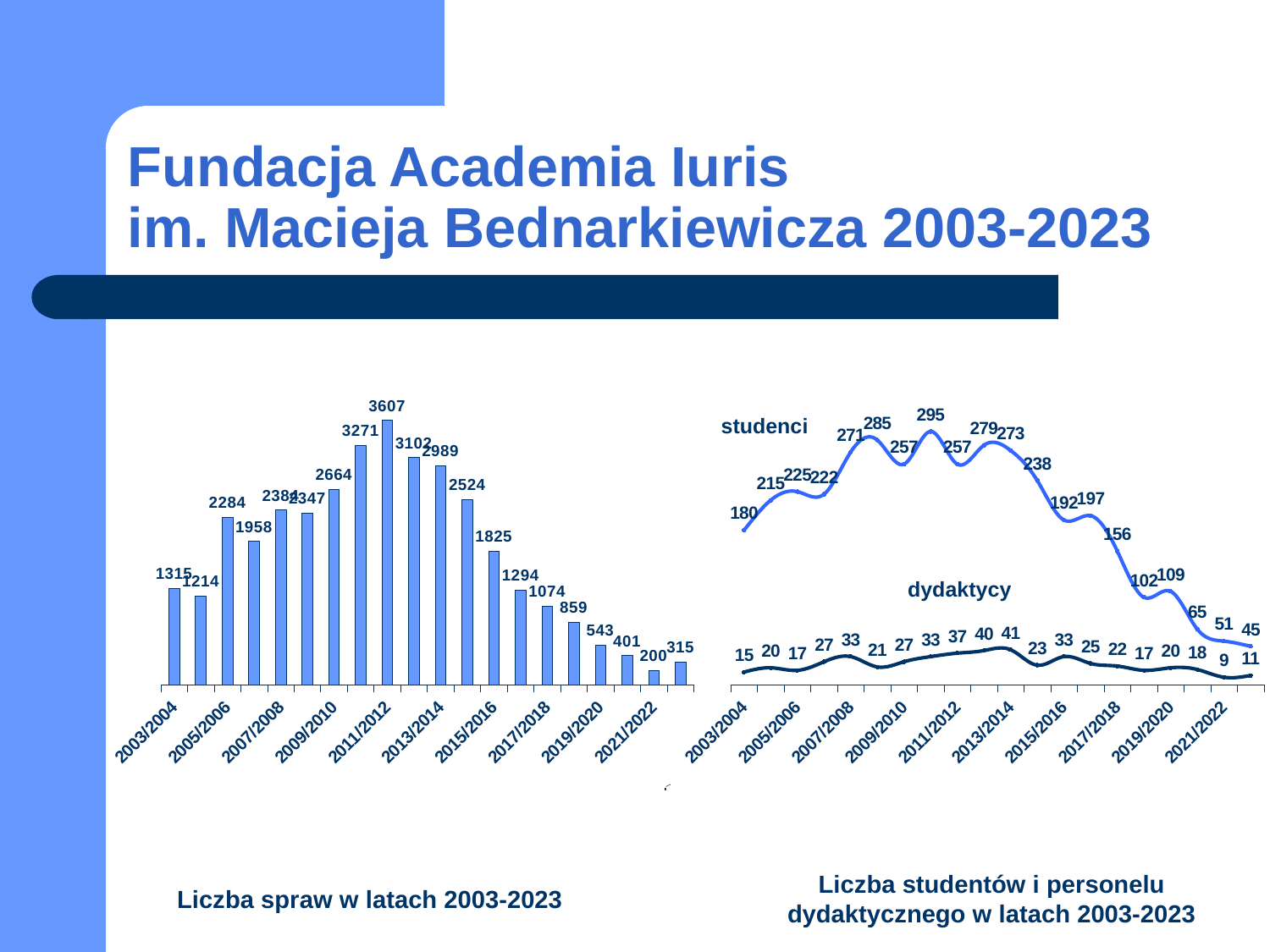
In the left chart 'Liczba spraw w latach 2003-2023', what is the difference between the highest bar (3607) and the bar just before it (3271)? 336 What kind of chart is the left chart, 'Liczba spraw w latach 2003-2023'? bar chart How many bars are plotted in the left chart 'Liczba spraw w latach 2003-2023'? 20 In the right chart, does the 'studenci' series rise or fall from 2013/2014 to 2021/2022? fall How many series are plotted in the right chart 'Liczba studentów i personelu dydaktycznego w latach 2003-2023'? 2 In the left chart 'Liczba spraw w latach 2003-2023', what is the value for 2003/2004? 1315 In the left chart 'Liczba spraw w latach 2003-2023', what is the highest value shown? 3607 In the right chart, what is the lowest value of the 'dydaktycy' series? 9 In the right chart, is the 'studenci' value higher in 2003/2004 or in 2021/2022? 2003/2004 In the right chart, what is the value of 'dydaktycy' for 2013/2014? 41 In the right chart, what is the highest value of the 'studenci' series? 295 In the left chart 'Liczba spraw w latach 2003-2023', what is the lowest value shown? 200